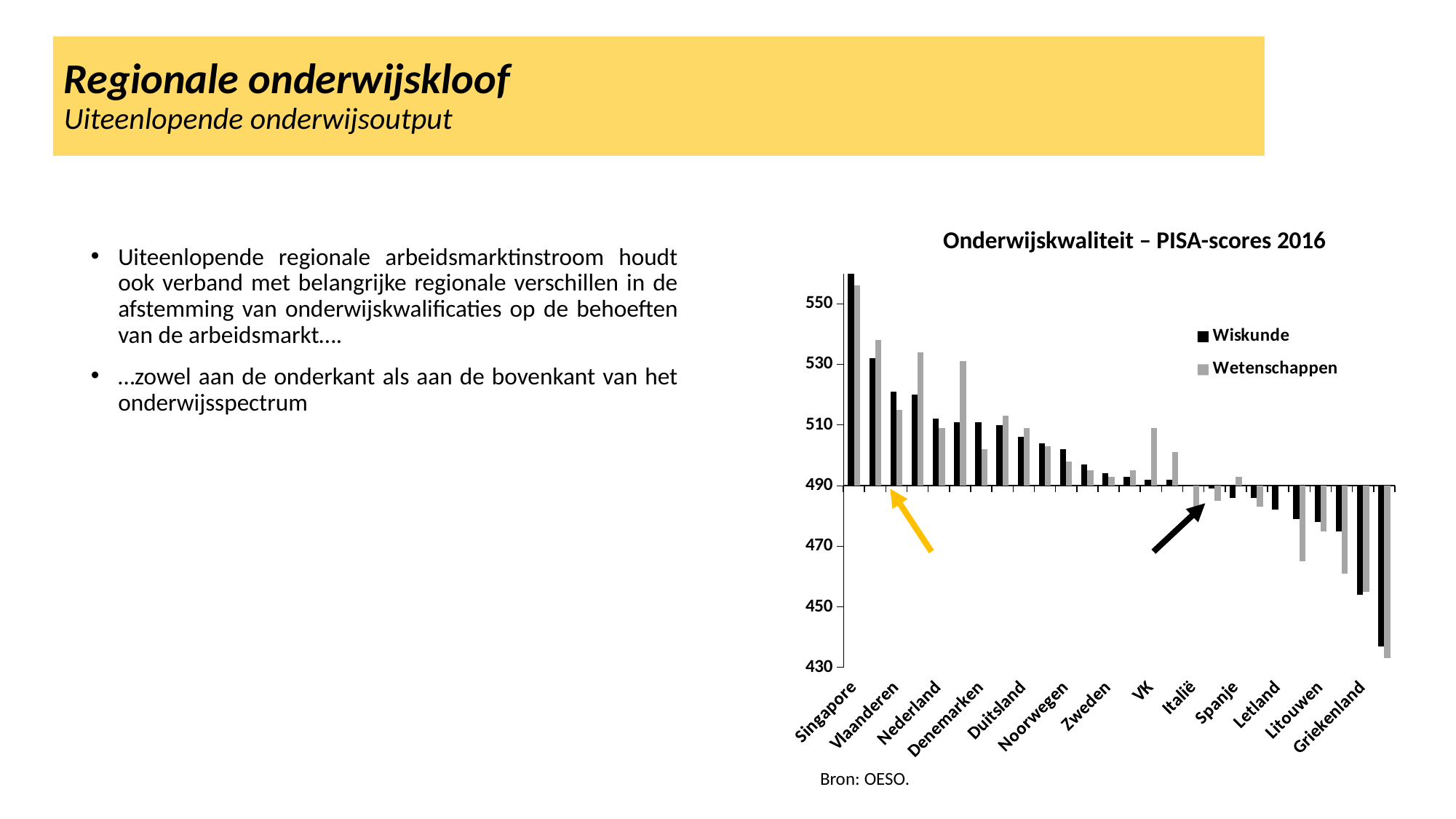
What is the title of the chart? Onderwijskwaliteit – PISA-scores 2016 What kind of chart is shown on the slide? bar chart Which series is shown in black in the chart? Wiskunde Do the Wiskunde scores rise or fall from left to right along the x axis? fall Which country has the highest Wiskunde score in the chart? Singapore Is the Wiskunde value for Vlaanderen greater or less than 510? greater Is the Wetenschappen value for Singapore greater or less than 550? greater Which has the larger Wiskunde score, Singapore or Griekenland? Singapore Is the Wiskunde value for Singapore greater or less than 550? greater How many series does the legend list? 2